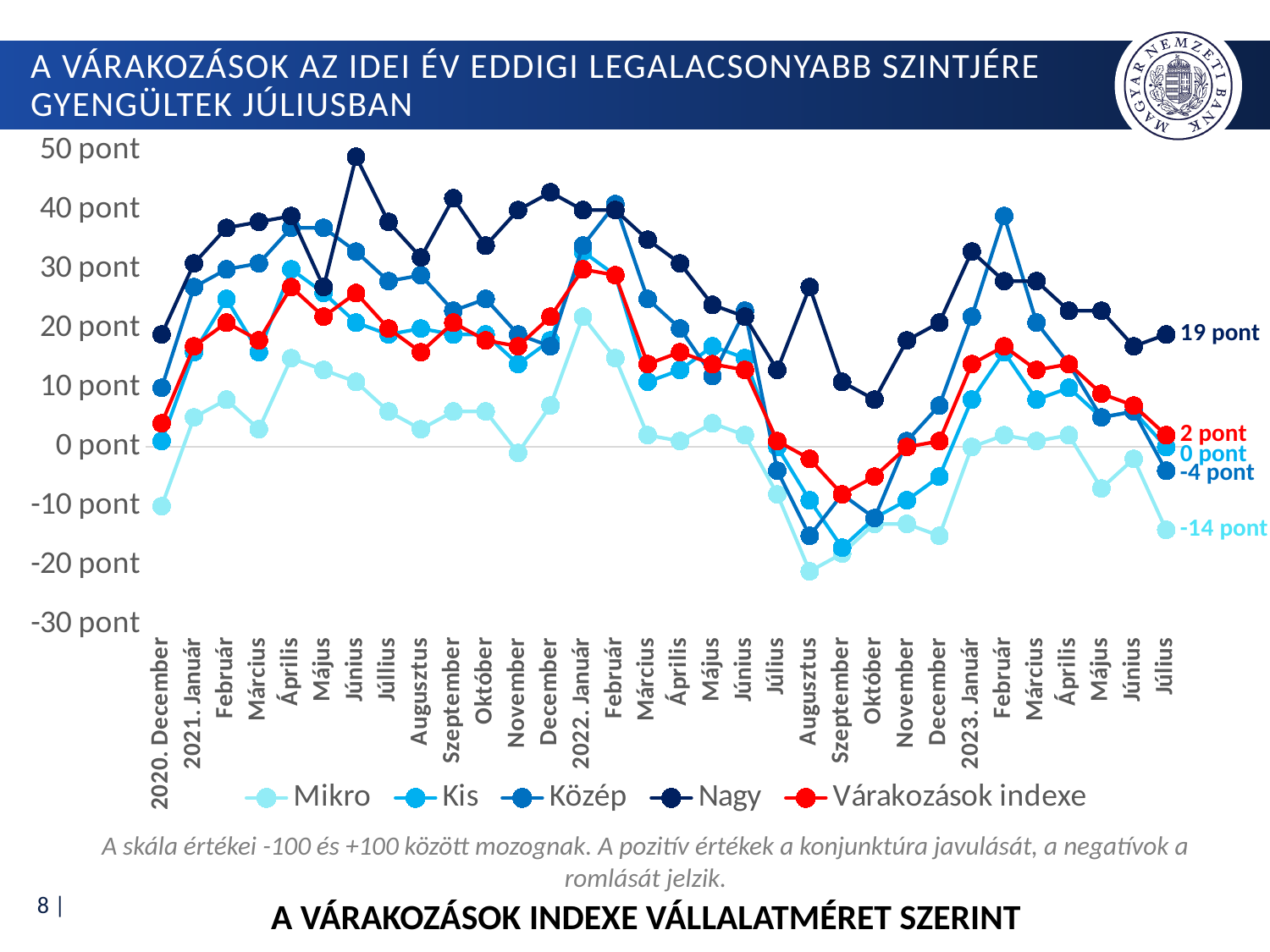
What kind of chart is shown on the slide? line chart What is the value of the Mikro series in 2023 Július? -14 pont What is the value of the Nagy series in 2023 Július? 19 pont What is the difference between the Nagy and Mikro values in 2023 Július? 33 pont What is the value of the Kis series in 2023 Július? 0 pont What is the value of the Várakozások indexe series in 2023 Július? 2 pont What is the value of the Közép series in 2023 Július? -4 pont What is the title of the chart? A VÁRAKOZÁSOK INDEXE VÁLLALATMÉRET SZERINT Which series has the lowest value in 2023 Július? Mikro Is the value for the Nagy series in 2021 Június greater or less than 40 pont? greater Which series has the highest value in 2023 Július? Nagy How many series does the legend list? 5